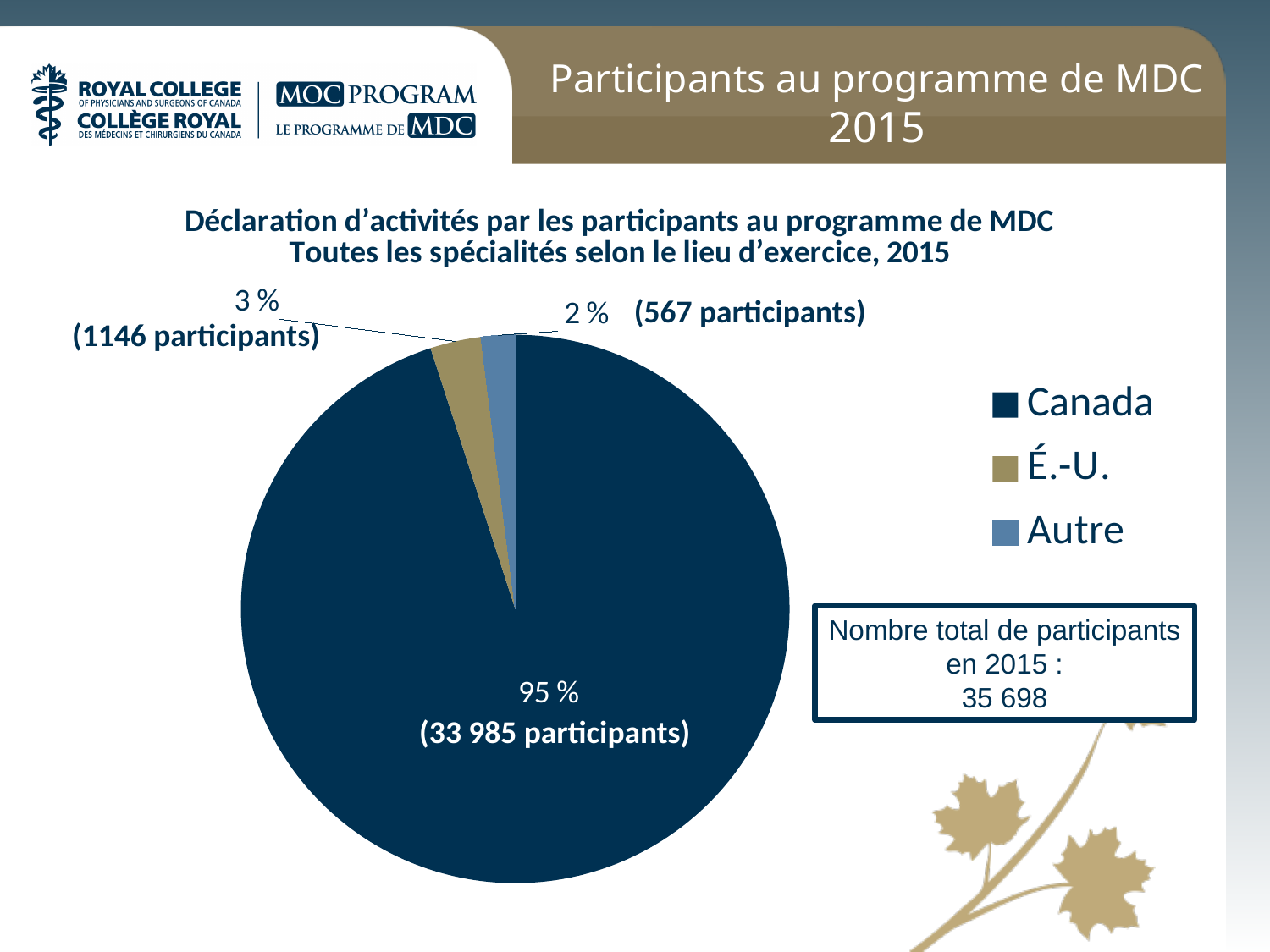
What percentage of participants does the É.-U. slice represent? 3 % How many entries does the legend list? 3 What is the total number of participants in 2015 shown in the box on the slide? 35 698 What percentage of participants does the Autre slice represent? 2 % Which category has the largest slice of the pie? Canada What percentage of participants does the Canada slice represent? 95 % How many participants are in the É.-U. slice? 1146 participants How many slices does the pie chart have? 3 How many participants are in the Autre slice? 567 participants How many participants are in the Canada slice? 33 985 participants What kind of chart is shown on the slide? pie chart Which category has the smallest slice of the pie? Autre